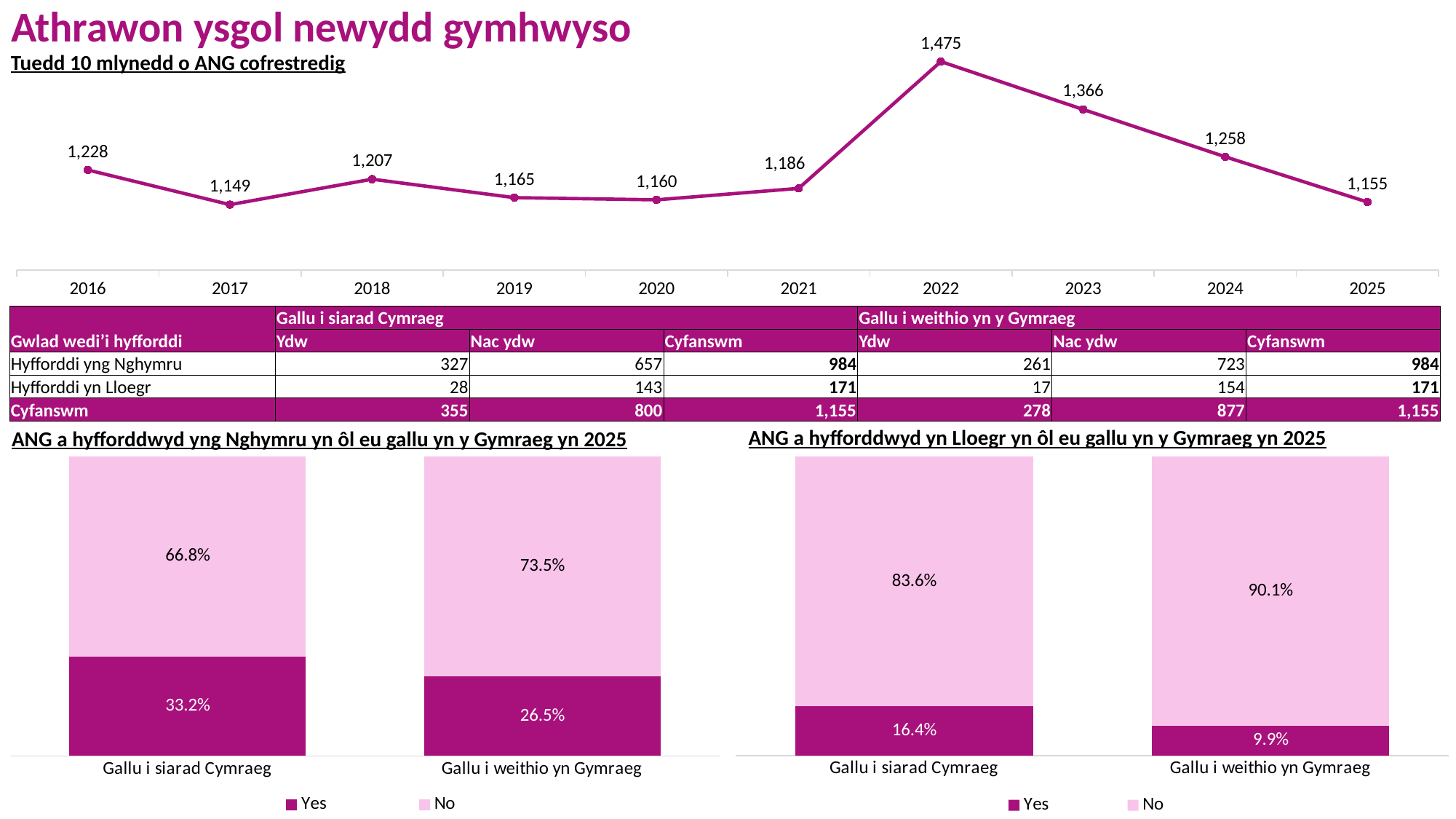
In the chart 'ANG a hyfforddwyd yn Lloegr yn ôl eu gallu yn y Gymraeg yn 2025', which is larger: the 'Yes' value for 'Gallu i siarad Cymraeg' or the 'Yes' value for 'Gallu i weithio yn Gymraeg'? Gallu i siarad Cymraeg In the line chart 'Tuedd 10 mlynedd o ANG cofrestredig', what is the value for 2022? 1,475 In the line chart 'Tuedd 10 mlynedd o ANG cofrestredig', what is the difference between the 2022 value and the 2025 value? 320 How many series does the legend of the chart 'ANG a hyfforddwyd yng Nghymru yn ôl eu gallu yn y Gymraeg yn 2025' list? 2 In the line chart 'Tuedd 10 mlynedd o ANG cofrestredig', which year has the highest value? 2022 In the line chart 'Tuedd 10 mlynedd o ANG cofrestredig', how many years are plotted? 10 In the line chart 'Tuedd 10 mlynedd o ANG cofrestredig', what is the value for 2016? 1,228 In the line chart 'Tuedd 10 mlynedd o ANG cofrestredig', do the values rise or fall from 2022 to 2025? fall In the line chart 'Tuedd 10 mlynedd o ANG cofrestredig', which year has the lowest value? 2017 What kind of chart is 'Tuedd 10 mlynedd o ANG cofrestredig'? line chart In the chart 'ANG a hyfforddwyd yng Nghymru yn ôl eu gallu yn y Gymraeg yn 2025', what is the 'Yes' value for 'Gallu i siarad Cymraeg'? 33.2% In the chart 'ANG a hyfforddwyd yn Lloegr yn ôl eu gallu yn y Gymraeg yn 2025', what is the 'No' value for 'Gallu i weithio yn Gymraeg'? 90.1%